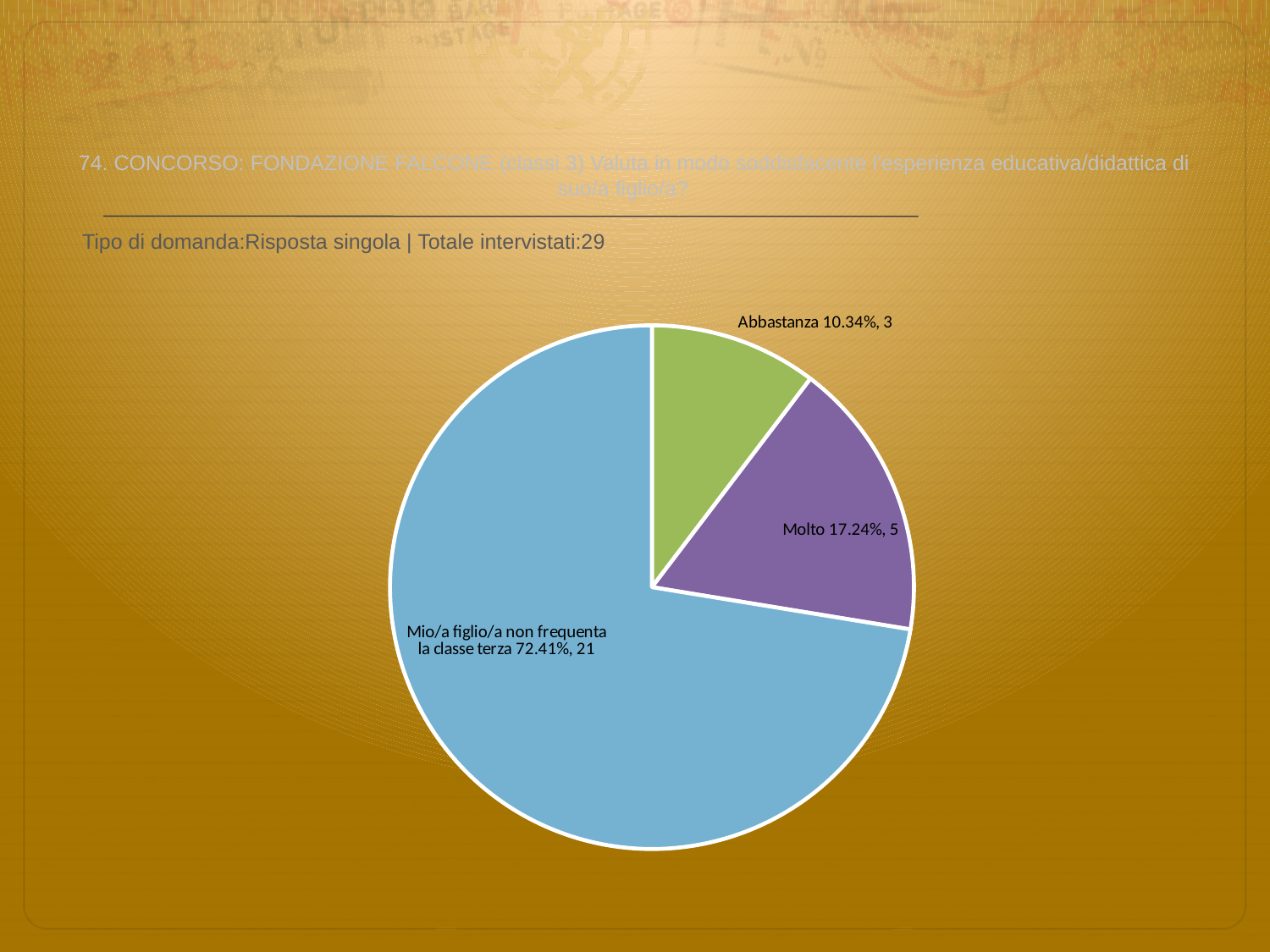
How many respondents chose 'Mio/a figlio/a non frequenta la classe terza'? 21 Which category has the largest slice? Mio/a figlio/a non frequenta la classe terza What kind of chart is shown on the slide? pie chart What percentage share does the 'Molto' slice have? 17.24% Which category has the smallest slice? Abbastanza How many slices does the pie chart have? 3 What percentage share does the 'Abbastanza' slice have? 10.34% Which slice is larger, 'Molto' or 'Abbastanza'? Molto What percentage share does the 'Mio/a figlio/a non frequenta la classe terza' slice have? 72.41% How many respondents chose 'Abbastanza'? 3 What is the difference in respondent count between 'Molto' and 'Abbastanza'? 2 How many respondents chose 'Molto'? 5